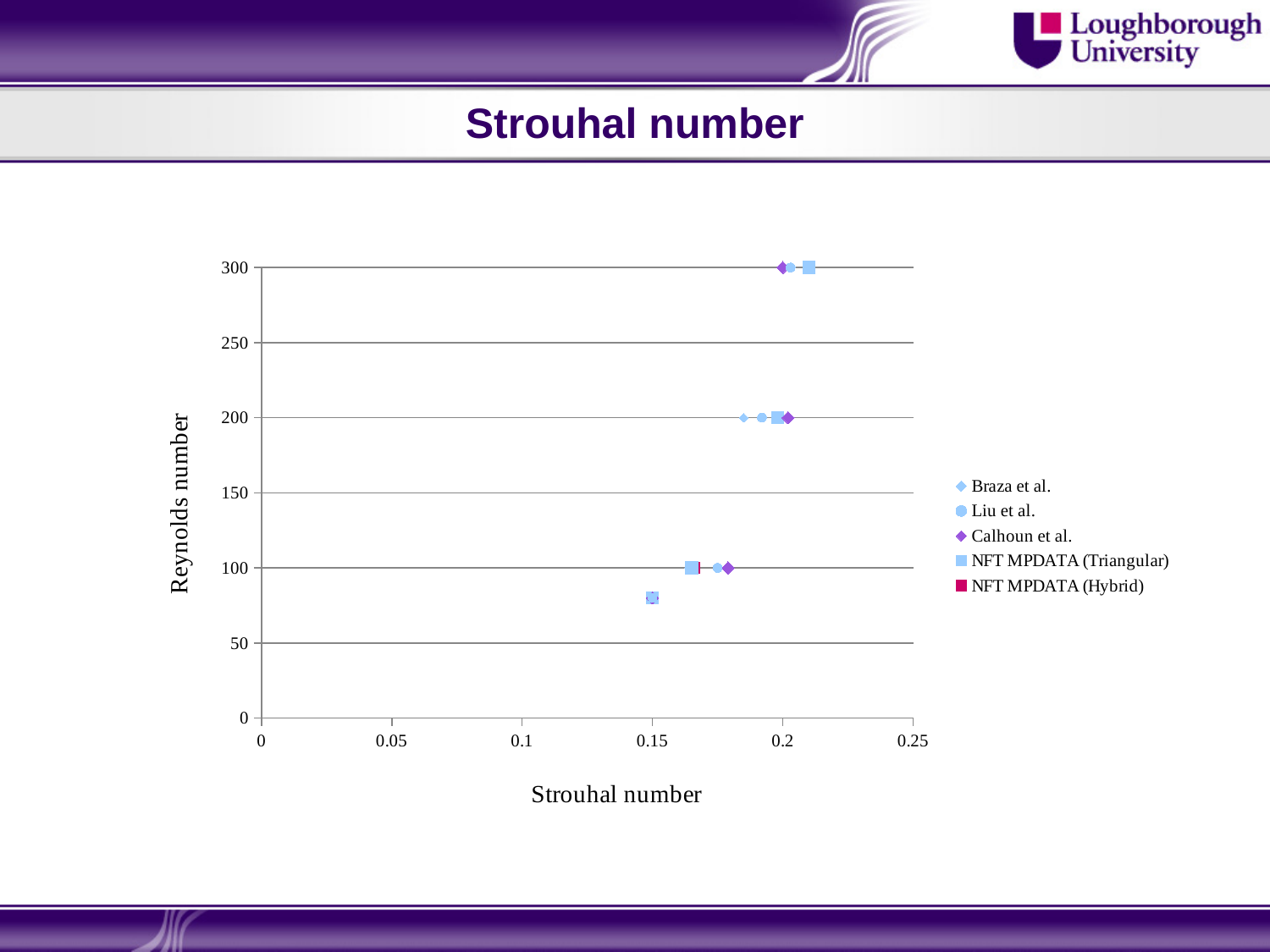
Is the Strouhal number for Braza et al. at Reynolds number 200 greater or less than 0.2? less Is the Strouhal number for Calhoun et al. at Reynolds number 100 greater or less than 0.2? less As the Reynolds number increases, does the Strouhal number rise or fall? rise At Reynolds number 300, which has the larger Strouhal number, NFT MPDATA (Triangular) or Calhoun et al.? NFT MPDATA (Triangular) At which Reynolds number are the highest Strouhal numbers plotted? 300 At Reynolds number 100, which has the larger Strouhal number, Calhoun et al. or NFT MPDATA (Triangular)? Calhoun et al. Is the Strouhal number for NFT MPDATA (Triangular) at Reynolds number 300 greater or less than 0.2? greater What kind of chart is shown on the slide? scatter chart What is the last series listed in the legend? NFT MPDATA (Hybrid) What is the title of the x axis? Strouhal number How many series does the legend list? 5